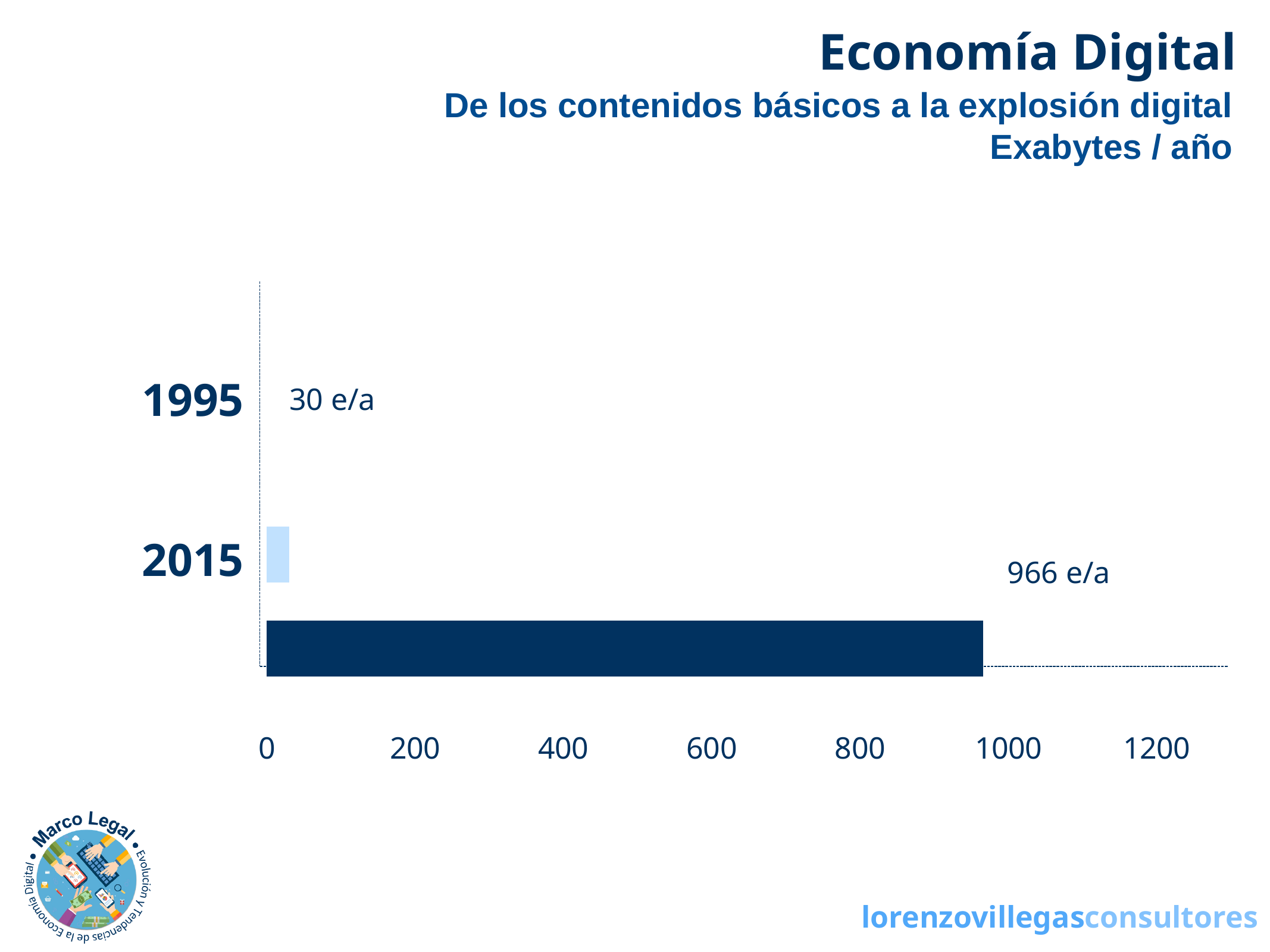
What unit is stated in the chart subtitle? Exabytes / año Is the value for 1995 greater or less than 200? less What value is shown for 1995? 30 e/a Which year has the highest value? 2015 What kind of chart is shown on the slide? bar chart Which year has the lowest value? 1995 What is the difference between the 2015 value and the 1995 value? 936 e/a Which year has the higher value, 1995 or 2015? 2015 Is the value for 2015 greater or less than 800? greater What is the highest tick value shown on the horizontal axis? 1200 How many years are shown in the chart? 2 What value is shown for 2015? 966 e/a